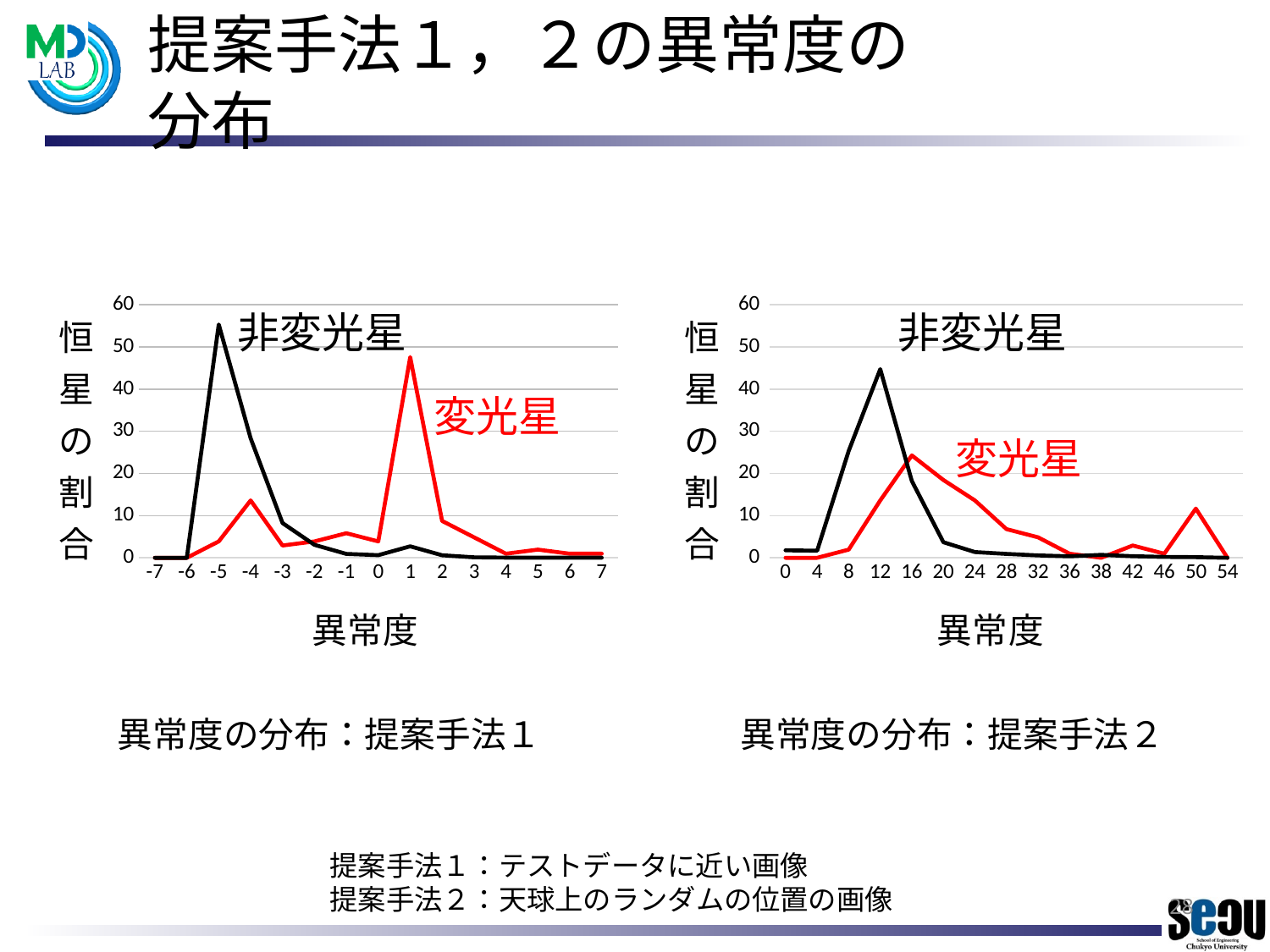
In the left chart (異常度の分布：提案手法１), at 異常度 = -5, which line is higher, 非変光星 or 変光星? 非変光星 In the left chart (異常度の分布：提案手法１), is the value of the 変光星 line at 異常度 = 1 greater or less than 40? greater In the right chart (異常度の分布：提案手法２), at which 異常度 value does the 変光星 line reach its highest point? 16 In the right chart (異常度の分布：提案手法２), at which 異常度 value does the 非変光星 line reach its highest point? 12 In the left chart (異常度の分布：提案手法１), is the peak value of the 非変光星 line greater or less than 50? greater In the left chart (異常度の分布：提案手法１), at which 異常度 value does the 非変光星 line reach its highest point? -5 In the right chart (異常度の分布：提案手法２), is the peak value of the 非変光星 line greater or less than 40? greater What kind of chart is the left chart (異常度の分布：提案手法１)? line chart In the left chart (異常度の分布：提案手法１), how many series are plotted? 2 In the right chart (異常度の分布：提案手法２), what is the label of the x axis? 異常度